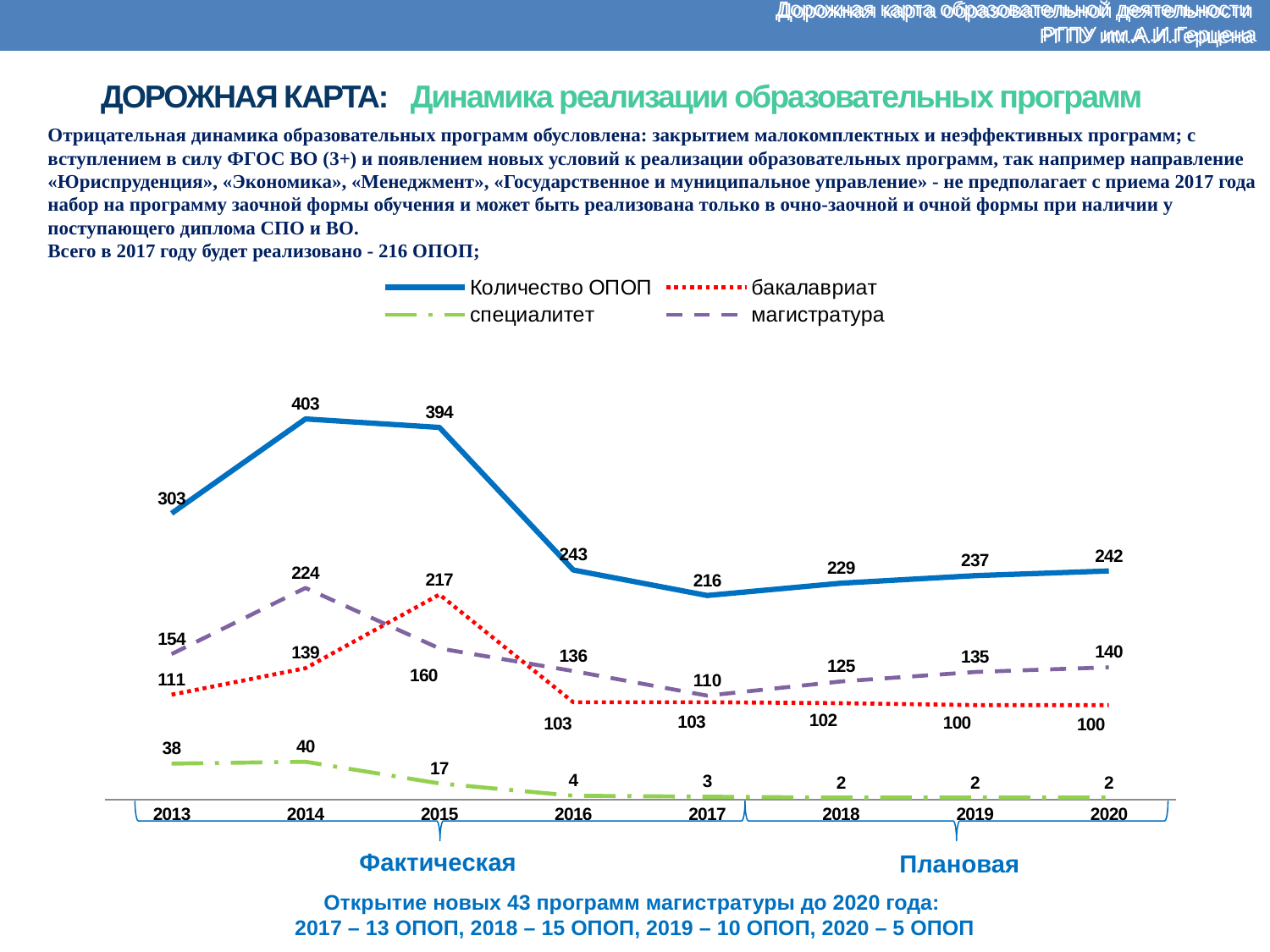
Does специалитет rise or fall from 2013 to 2020? fall How many series does the legend list? 4 Which is larger in 2016: бакалавриат or магистратура? магистратура What type of chart is shown on the slide? line chart What is the value of Количество ОПОП in 2014? 403 In which year is Количество ОПОП highest? 2014 How many years are shown on the x axis? 8 What is the value of специалитет in 2013? 38 What is the difference between Количество ОПОП in 2014 and in 2017? 187 In which year is Количество ОПОП lowest? 2017 What is the value of магистратура in 2020? 140 What is the value of бакалавриат in 2015? 217